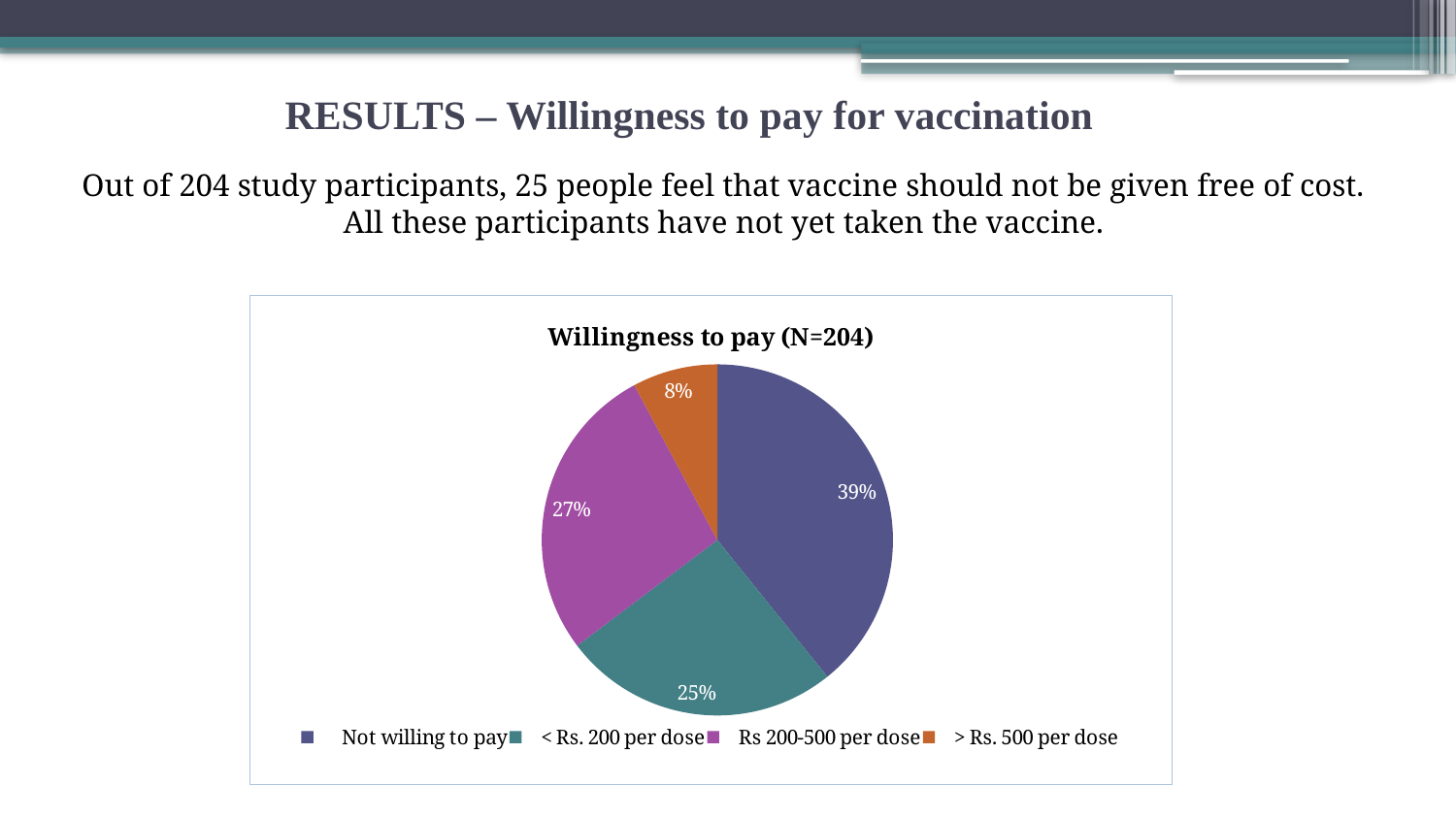
Which category has the largest share of the pie? Not willing to pay What percentage of participants are not willing to pay? 39% What is the difference in percentage points between 'Not willing to pay' and '> Rs. 500 per dose'? 31 What percentage of participants are willing to pay < Rs. 200 per dose? 25% What percentage of participants are willing to pay Rs 200-500 per dose? 27% What is the title of the chart? Willingness to pay (N=204) Which category has the smallest share of the pie? > Rs. 500 per dose What kind of chart is shown on the slide? Pie chart What colour represents the '> Rs. 500 per dose' slice? Orange How many categories does the legend list? 4 Which is larger: the share for 'Rs 200-500 per dose' or the share for '< Rs. 200 per dose'? Rs 200-500 per dose What percentage of participants are willing to pay > Rs. 500 per dose? 8%